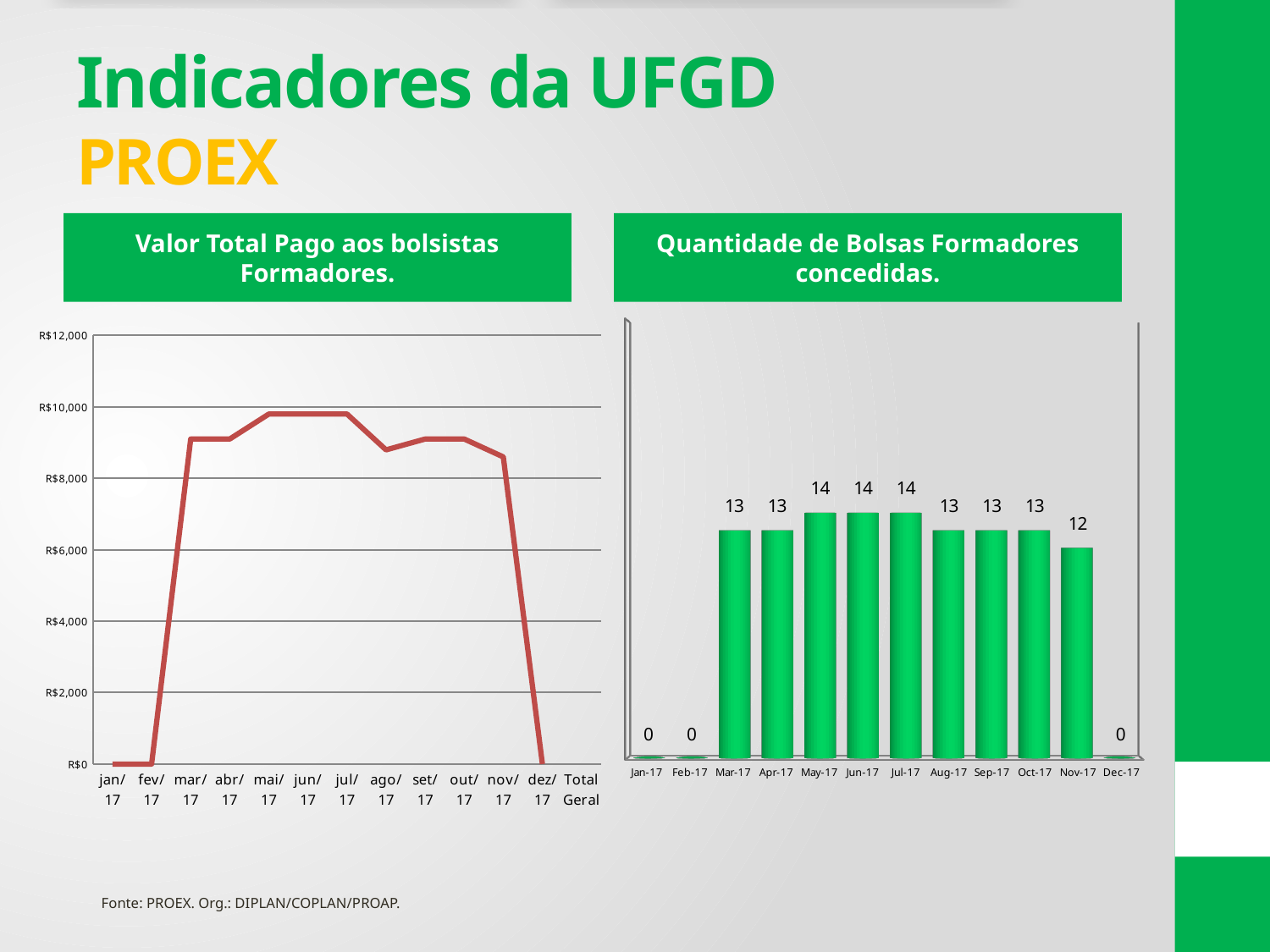
In the chart titled 'Valor Total Pago aos bolsistas Formadores.', is the value for mar/17 greater or less than R$6,000? greater In the chart titled 'Valor Total Pago aos bolsistas Formadores.', is the value for jan/17 greater or less than R$2,000? less In the chart titled 'Quantidade de Bolsas Formadores concedidas.', do the values rise or fall from Jul-17 to Nov-17? Fall What kind of chart is the one titled 'Quantidade de Bolsas Formadores concedidas.'? Bar chart In the chart titled 'Quantidade de Bolsas Formadores concedidas.', how many months are shown on the x axis? 12 In the chart titled 'Quantidade de Bolsas Formadores concedidas.', what is the value for Jun-17? 14 In the chart titled 'Quantidade de Bolsas Formadores concedidas.', what is the difference between the values for May-17 and Nov-17? 2 In the chart titled 'Valor Total Pago aos bolsistas Formadores.', is the value for mai/17 greater or less than R$8,000? greater In the chart titled 'Quantidade de Bolsas Formadores concedidas.', which is larger, the value for Mar-17 or the value for Nov-17? Mar-17 What kind of chart is the one titled 'Valor Total Pago aos bolsistas Formadores.'? Line chart In the chart titled 'Quantidade de Bolsas Formadores concedidas.', what is the value for Nov-17? 12 In the chart titled 'Quantidade de Bolsas Formadores concedidas.', what is the value for Mar-17? 13